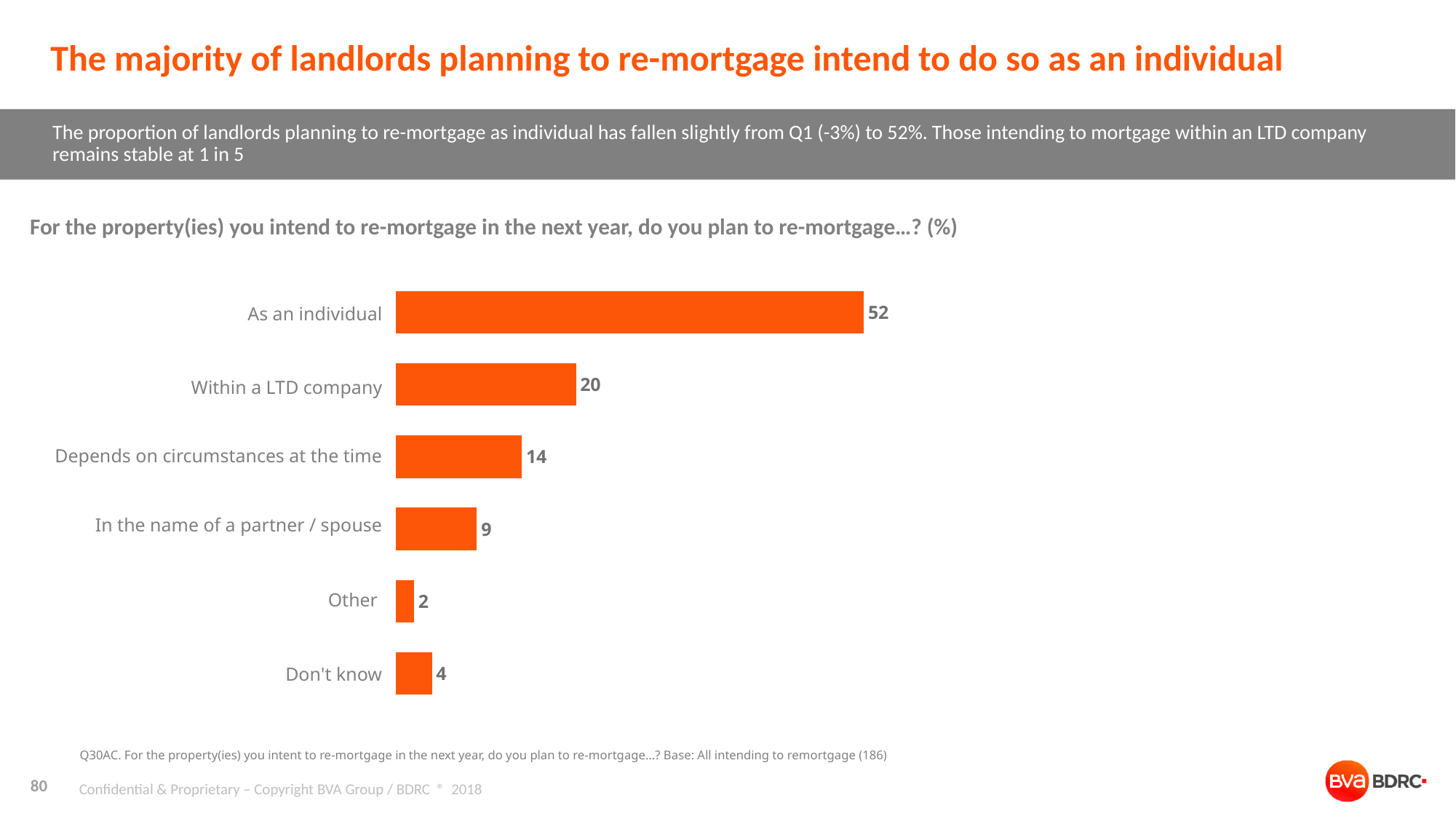
What is the difference between the values for 'As an individual' and 'Within a LTD company'? 32 What is the value for 'Don't know'? 4 What is the value for 'Within a LTD company'? 20 What is the value for 'Depends on circumstances at the time'? 14 Which category has the highest value? As an individual How many categories are shown in the chart? 6 What kind of chart is shown on the slide? Bar chart What is the value for 'As an individual'? 52 Which category has the lowest value? Other Which is larger, the value for 'Don't know' or the value for 'Other'? Don't know What is the value for 'In the name of a partner / spouse'? 9 What colour are the bars in the chart? Orange